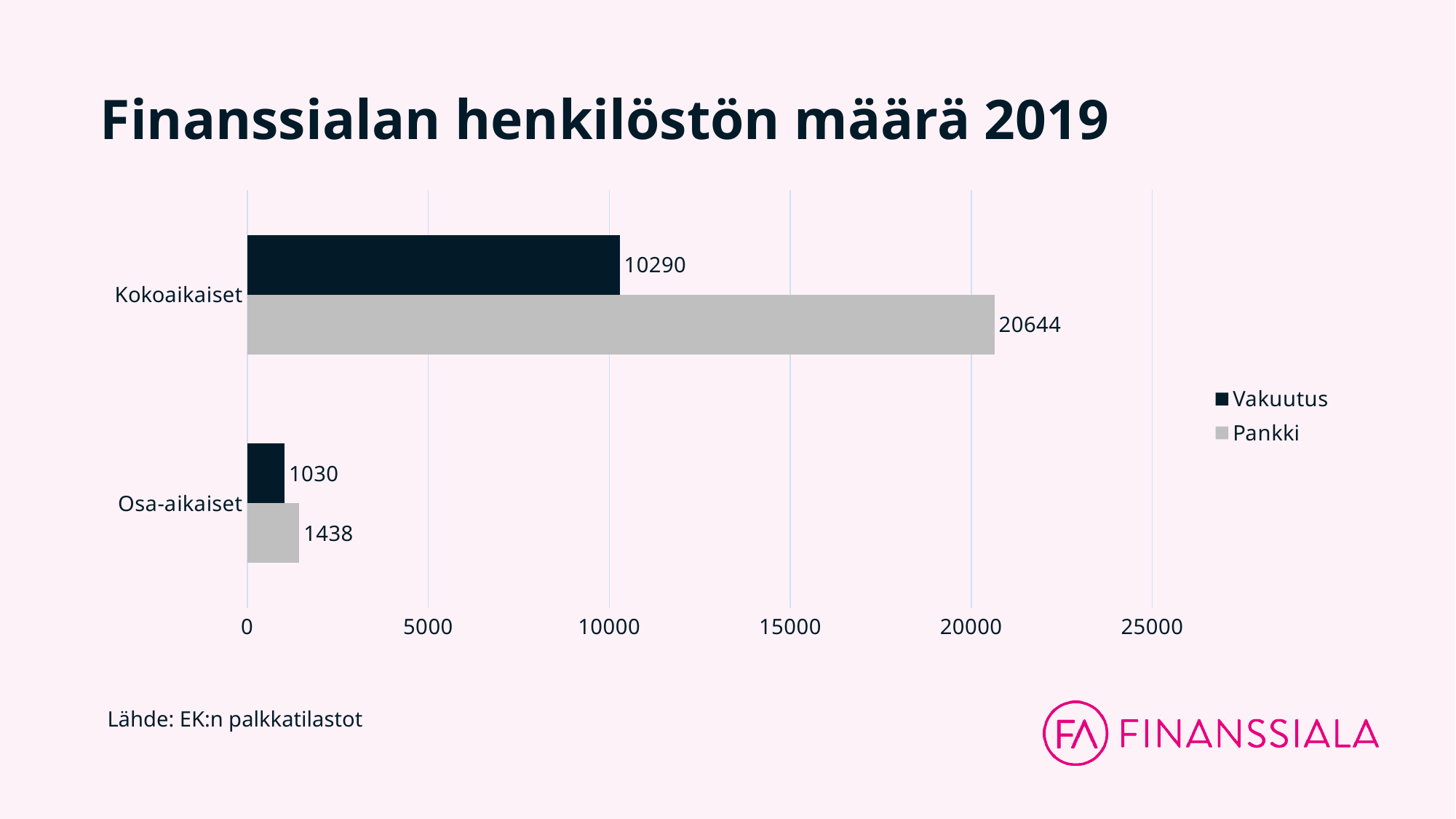
Which category has the highest Pankki value? Kokoaikaiset What kind of chart is shown on the slide? Bar chart How many series does the legend list? 2 What is the Pankki value for Osa-aikaiset? 1438 How many categories are shown on the chart? 2 For Osa-aikaiset, which series has the larger value, Vakuutus or Pankki? Pankki What is the difference between the Pankki and Vakuutus values for Kokoaikaiset? 10354 What is the Vakuutus value for Kokoaikaiset? 10290 What is the Vakuutus value for Osa-aikaiset? 1030 What is the Pankki value for Kokoaikaiset? 20644 Which category has the lowest Vakuutus value? Osa-aikaiset What is the difference between the Pankki and Vakuutus values for Osa-aikaiset? 408